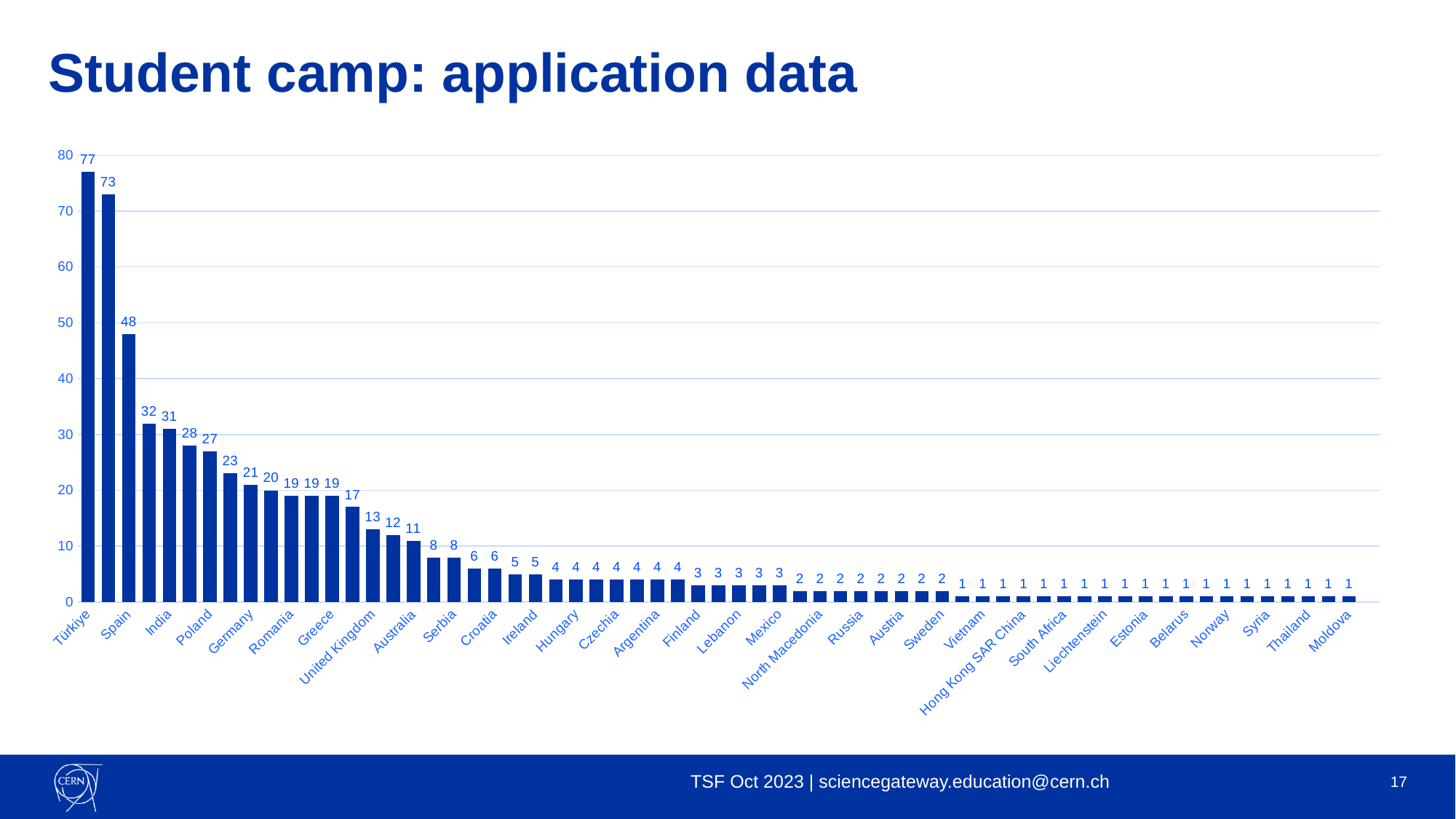
Is the value for Türkiye greater or less than 70? greater What is the value shown for Moldova? 1 What type of chart is shown on the slide? bar chart Which has a larger value, Türkiye or Moldova? Türkiye Do the bar values rise or fall from left to right along the x axis? fall What is the value shown for Türkiye? 77 What is the second highest value labelled on a bar in the chart? 73 What is the title of the slide containing the chart? Student camp: application data Which country has the highest number of applications? Türkiye What is the maximum value shown on the y axis? 80 What is the highest value labelled on any bar in the chart? 77 What is the difference between the values for Türkiye and Moldova? 76